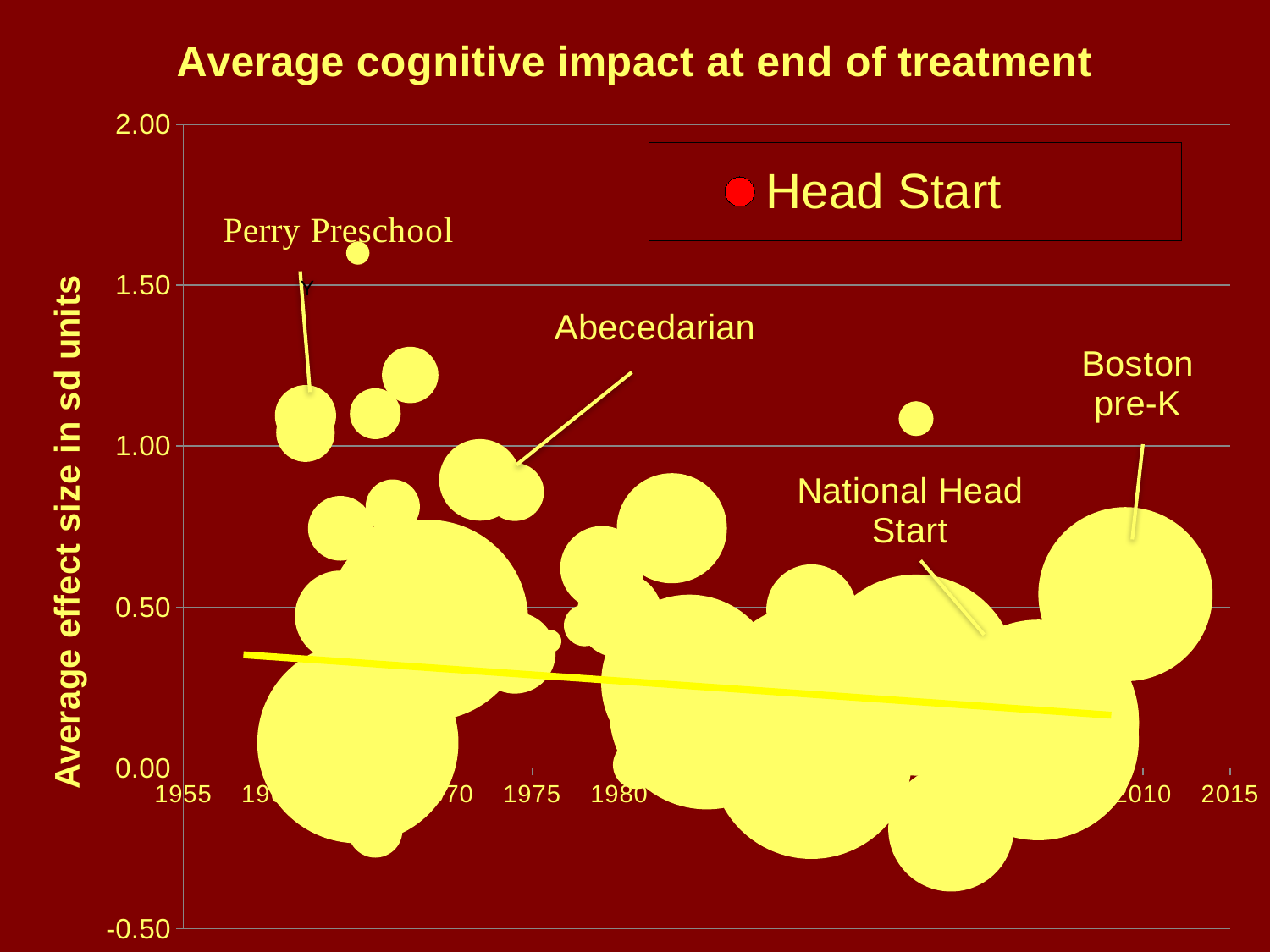
Is the value for Perry Preschool greater or less than 1.50? less Does the trend line rise or fall as the year increases along the x axis? Falls What kind of chart is shown on the slide? Bubble chart How many series does the chart legend list? 1 What is the title of the chart? Average cognitive impact at end of treatment Is the value for Abecedarian greater or less than 1.00? less Is the value for National Head Start greater or less than 1.00? less What is the highest value shown on the y axis? 2.00 What series name appears in the chart legend? Head Start